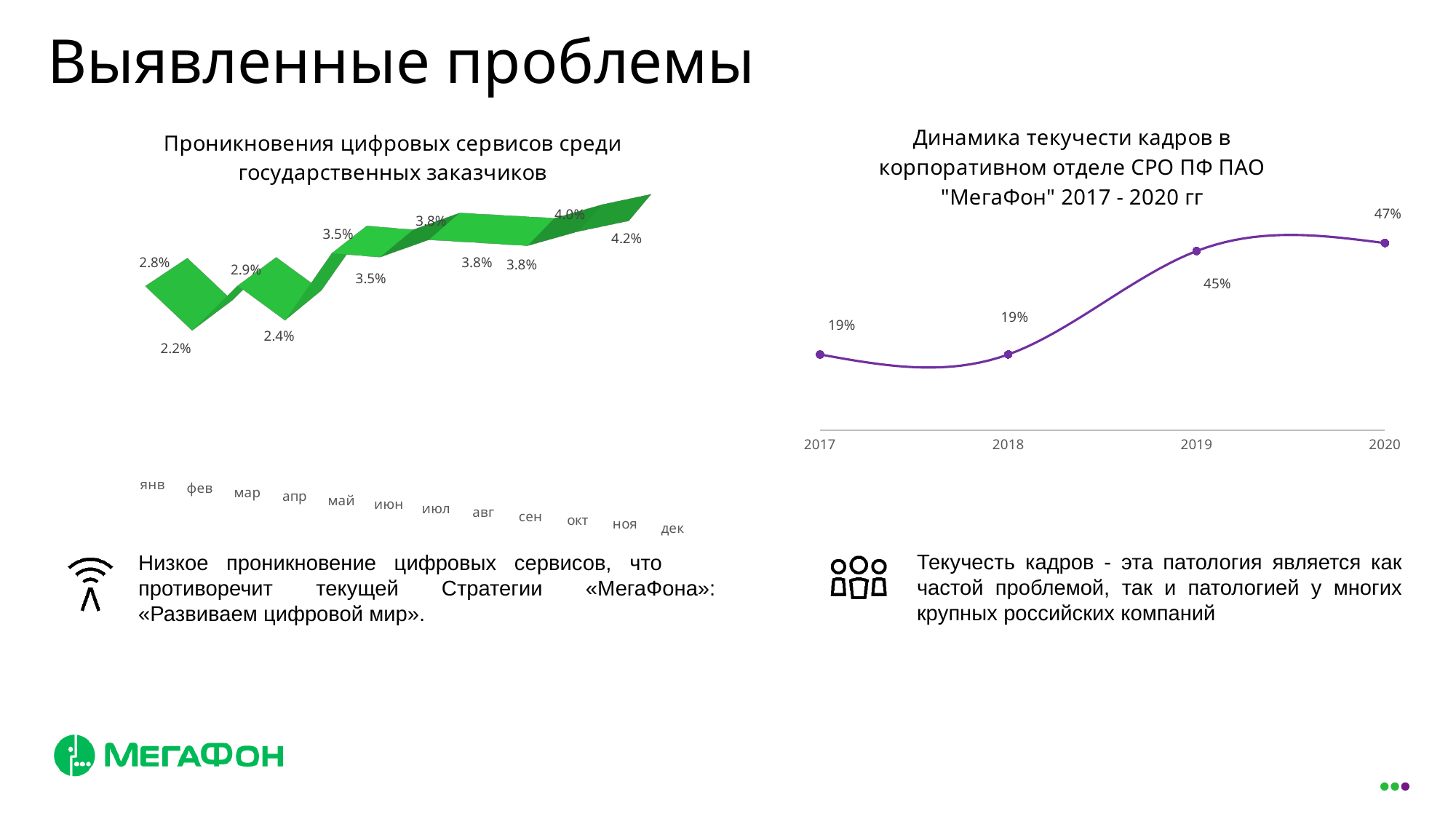
What is the title of the left chart? Проникновения цифровых сервисов среди государственных заказчиков On the right chart (Динамика текучести кадров), how many years are plotted? 4 On the right chart (Динамика текучести кадров), do the values generally rise or fall from 2017 to 2020? rise On the right chart (Динамика текучести кадров), what is the value for 2020? 47% On the right chart (Динамика текучести кадров), which is larger, the value for 2018 or the value for 2019? 2019 On the right chart (Динамика текучести кадров), what is the difference between the 2020 value and the 2017 value? 28 percentage points On the right chart (Динамика текучести кадров), which year has the highest value? 2020 On the right chart (Динамика текучести кадров), what is the value for 2017? 19% On the right chart (Динамика текучести кадров), what is the value for 2019? 45% What kind of chart is the right chart (Динамика текучести кадров)? line chart On the left chart (Проникновения цифровых сервисов), what is the lowest value labelled? 2.2% On the left chart (Проникновения цифровых сервисов), how many months are shown on the x axis? 12